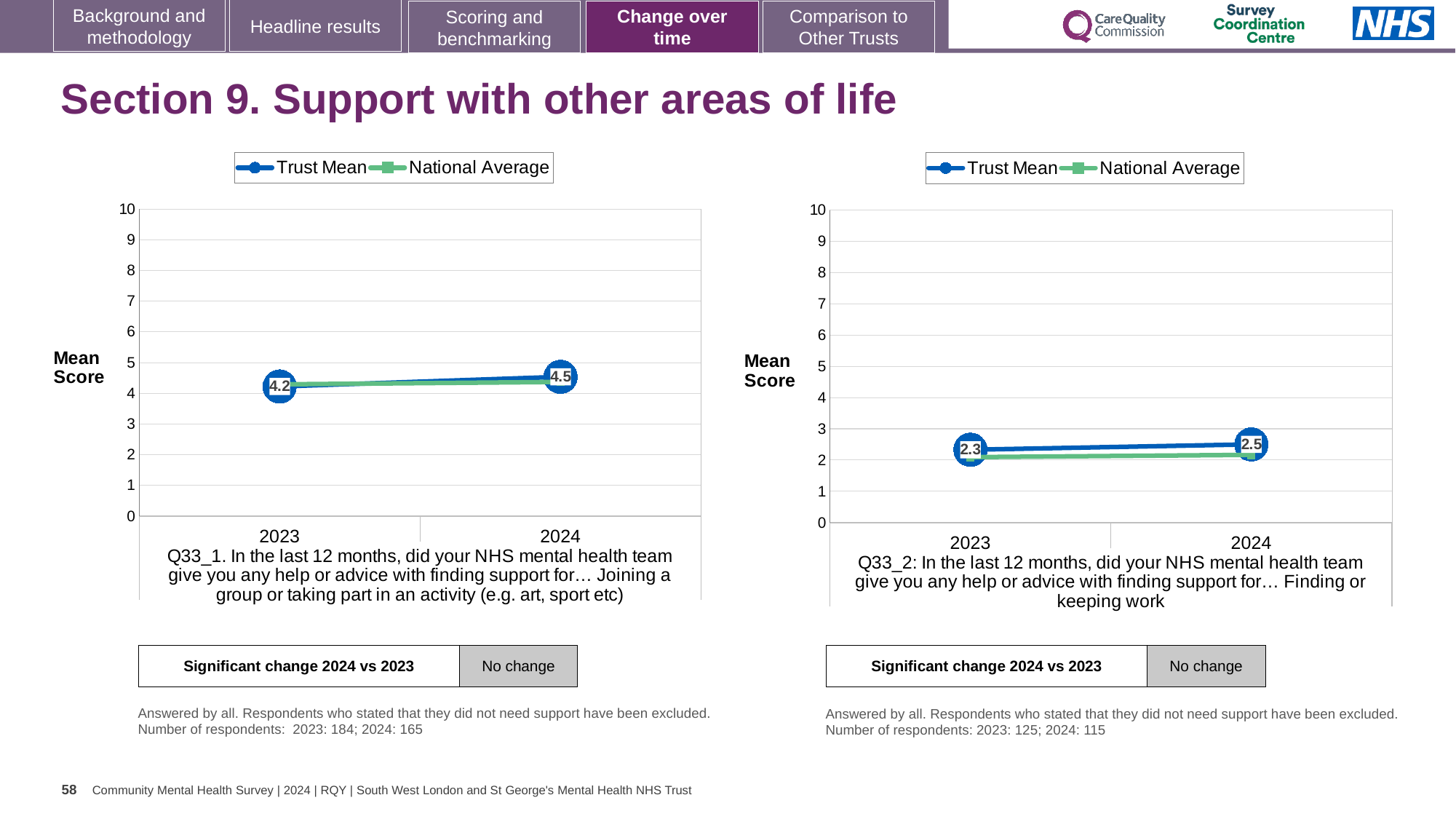
In the right chart (Q33_2), does the Trust Mean rise or fall from 2023 to 2024? rise In the right chart (Q33_2), is the National Average for 2024 greater or less than 3? less How many years are plotted on the x axis of the left chart (Q33_1)? 2 In the left chart (Q33_1), by how much did the Trust Mean change from 2023 to 2024? 0.3 What kind of chart is the left chart (Q33_1)? line chart In the left chart (Q33_1), what is the Trust Mean for 2023? 4.2 In the right chart (Q33_2), what is the Trust Mean for 2024? 2.5 How many series does the legend of the right chart (Q33_2) list? 2 In the left chart (Q33_1), which year has the higher Trust Mean, 2023 or 2024? 2024 In the right chart (Q33_2), what is the difference between the Trust Mean in 2024 and in 2023? 0.2 In the right chart (Q33_2), what is the Trust Mean for 2023? 2.3 In the left chart (Q33_1), what is the Trust Mean for 2024? 4.5